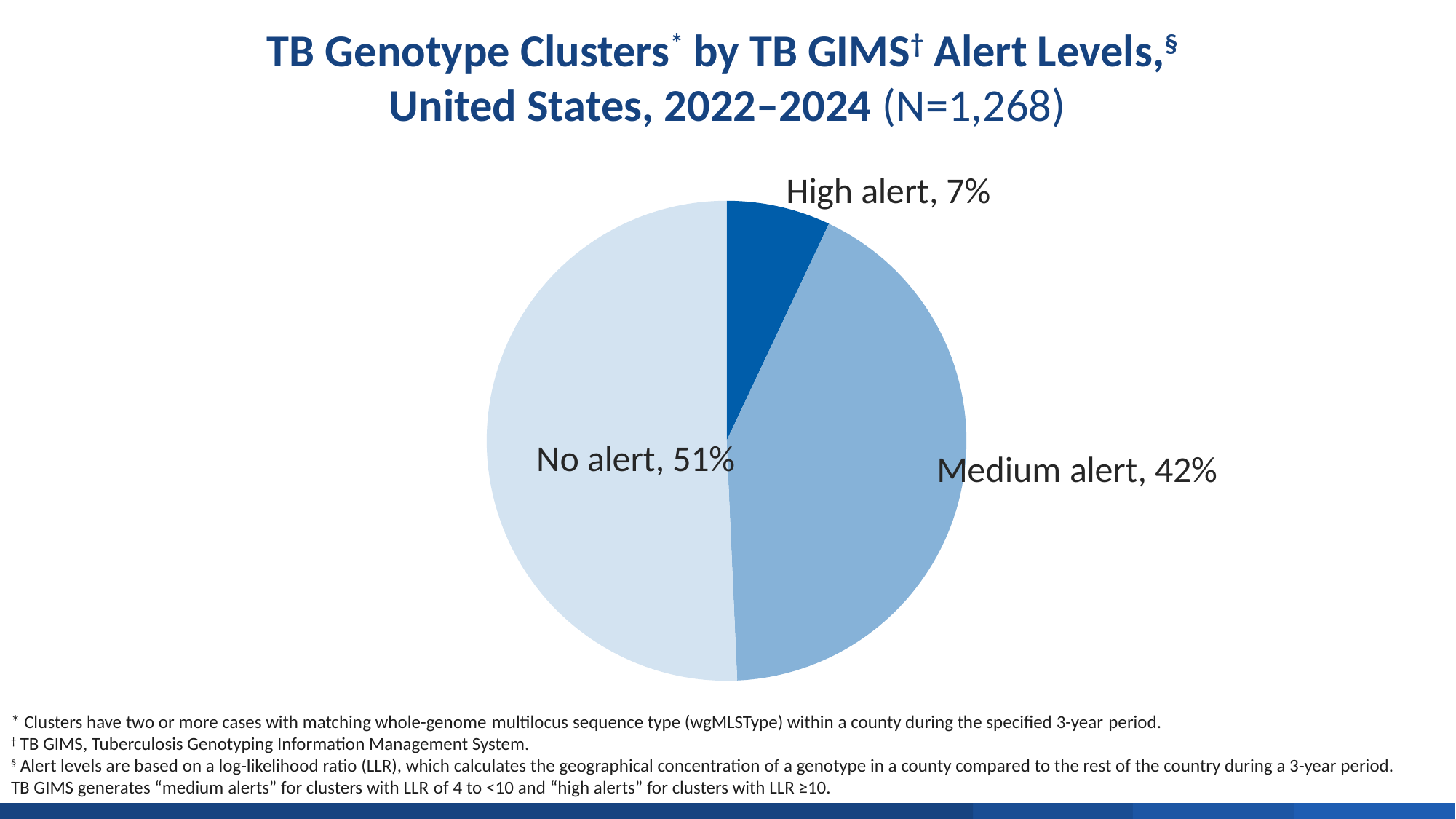
Which alert level accounts for the largest share of clusters? No alert Which alert level accounts for the smallest share of clusters? High alert What share of TB genotype clusters had a high alert? 7% What is the difference in percentage points between the No alert and Medium alert shares? 9 percentage points What time period does the chart cover? 2022–2024 What share of TB genotype clusters had a medium alert? 42% How many slices does the pie chart have? 3 Which is larger, the share of clusters with a medium alert or with a high alert? Medium alert What kind of chart is shown on the slide? Pie chart What is the difference in percentage points between the Medium alert and High alert shares? 35 percentage points What is the total number of clusters (N) given in the chart title? 1,268 What share of TB genotype clusters had no alert? 51%